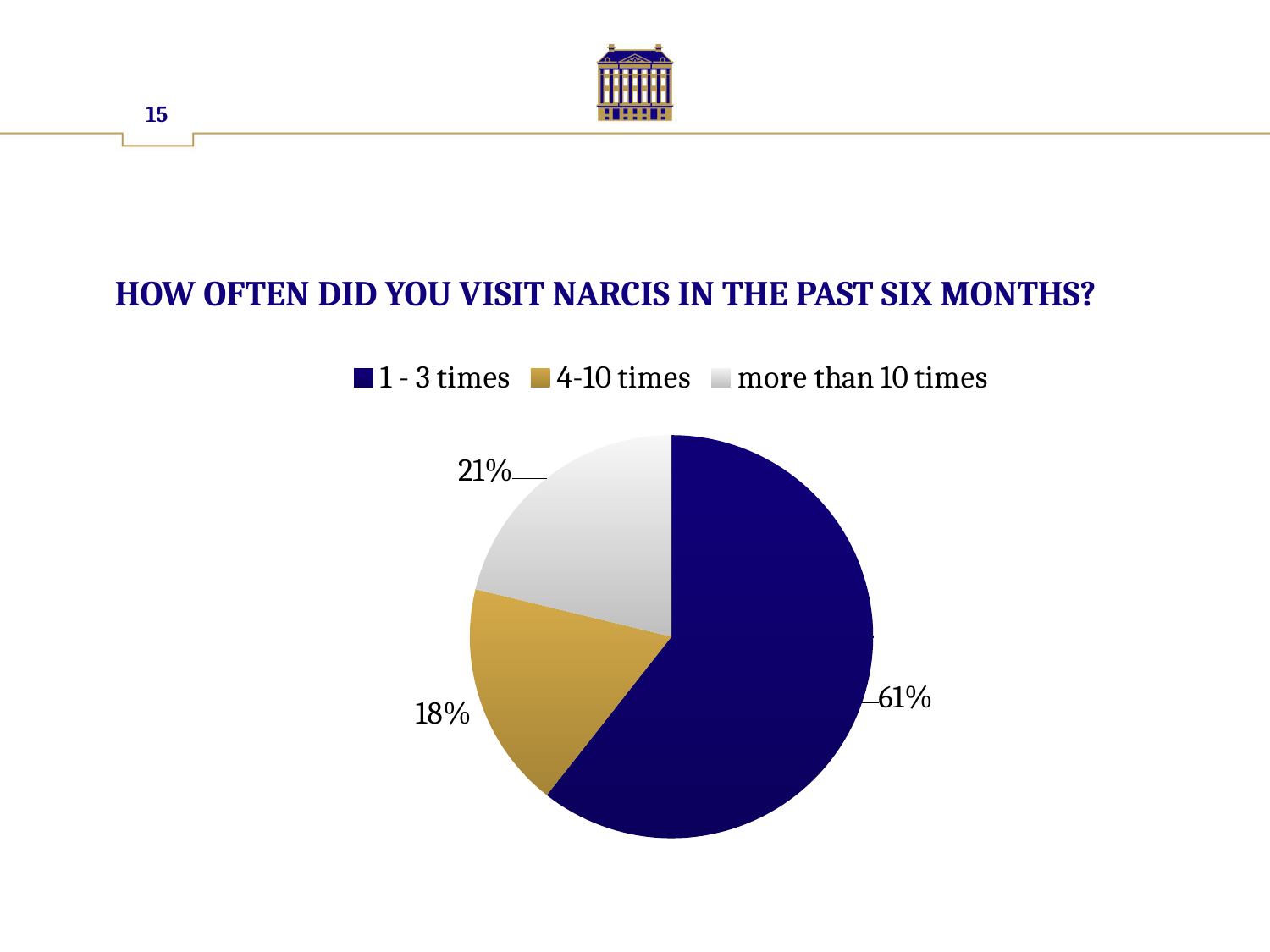
What share of respondents visited NARCIS 4-10 times? 18% What share of respondents visited NARCIS 1 - 3 times in the past six months? 61% Which visit-frequency category has the largest share of the pie? 1 - 3 times What is the difference in percentage points between the 'more than 10 times' slice and the '4-10 times' slice? 3 What is the title of the chart on the slide? HOW OFTEN DID YOU VISIT NARCIS IN THE PAST SIX MONTHS? What is the difference in percentage points between the '1 - 3 times' slice and the 'more than 10 times' slice? 40 How many categories does the pie chart show? 3 Which is larger: the share for '4-10 times' or the share for 'more than 10 times'? more than 10 times What share of respondents visited NARCIS more than 10 times? 21% What kind of chart is shown on the slide? pie chart Which visit-frequency category has the smallest share of the pie? 4-10 times Which colour represents the '4-10 times' category in the legend? gold